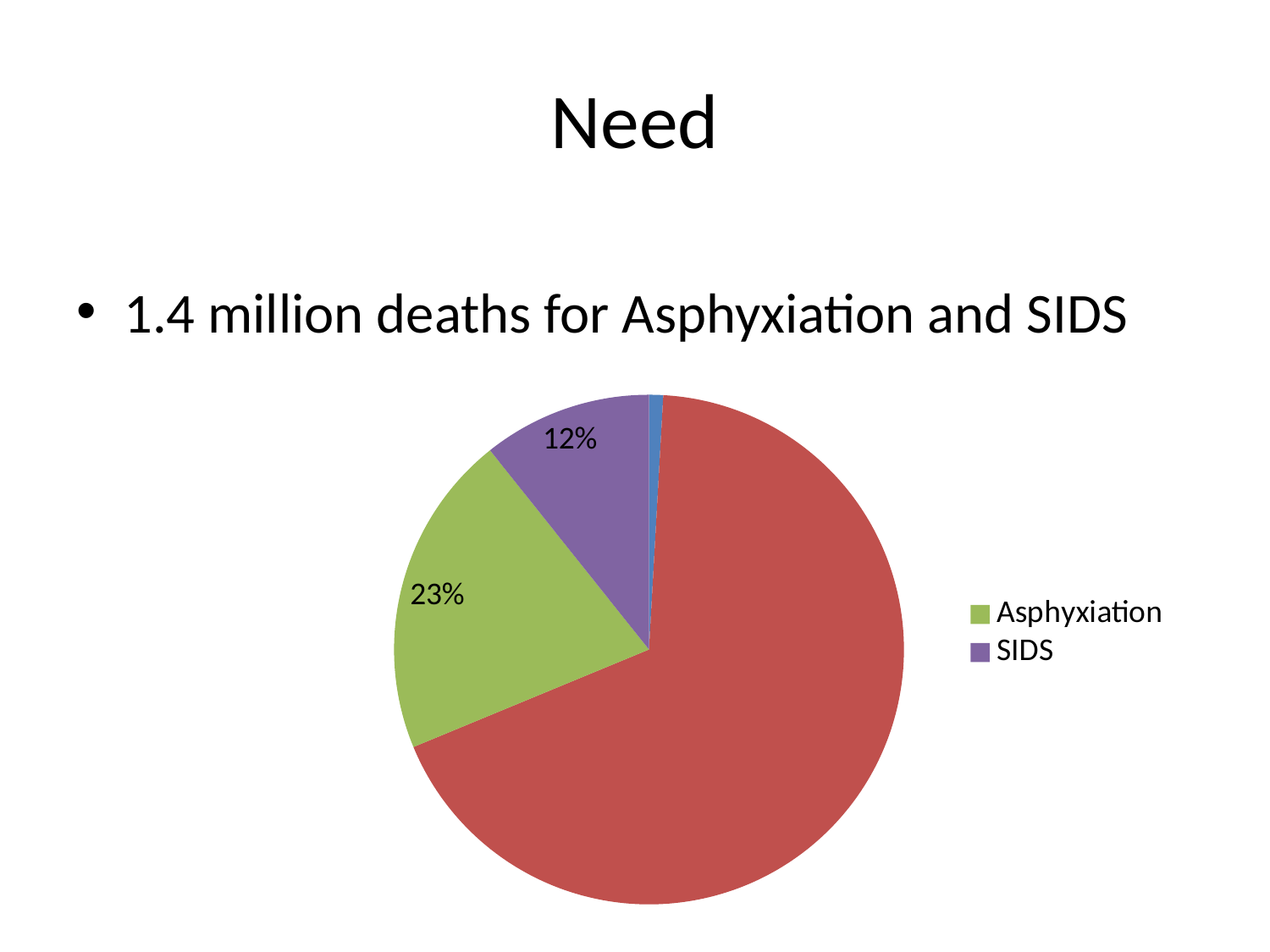
Which is larger, the Asphyxiation slice or the SIDS slice? Asphyxiation What colour is the SIDS slice in the pie chart? Purple Of the two slices named in the legend, which has the larger share? Asphyxiation Of the two slices named in the legend, which has the smaller share? SIDS By how many percentage points does the Asphyxiation share exceed the SIDS share? 11 percentage points What is the combined share of the Asphyxiation and SIDS slices? 35% How many entries does the chart legend list? 2 What percentage of the pie does the Asphyxiation slice represent? 23% What kind of chart is shown on the slide? Pie chart What colour is the Asphyxiation slice in the pie chart? Green What percentage of the pie does the SIDS slice represent? 12%